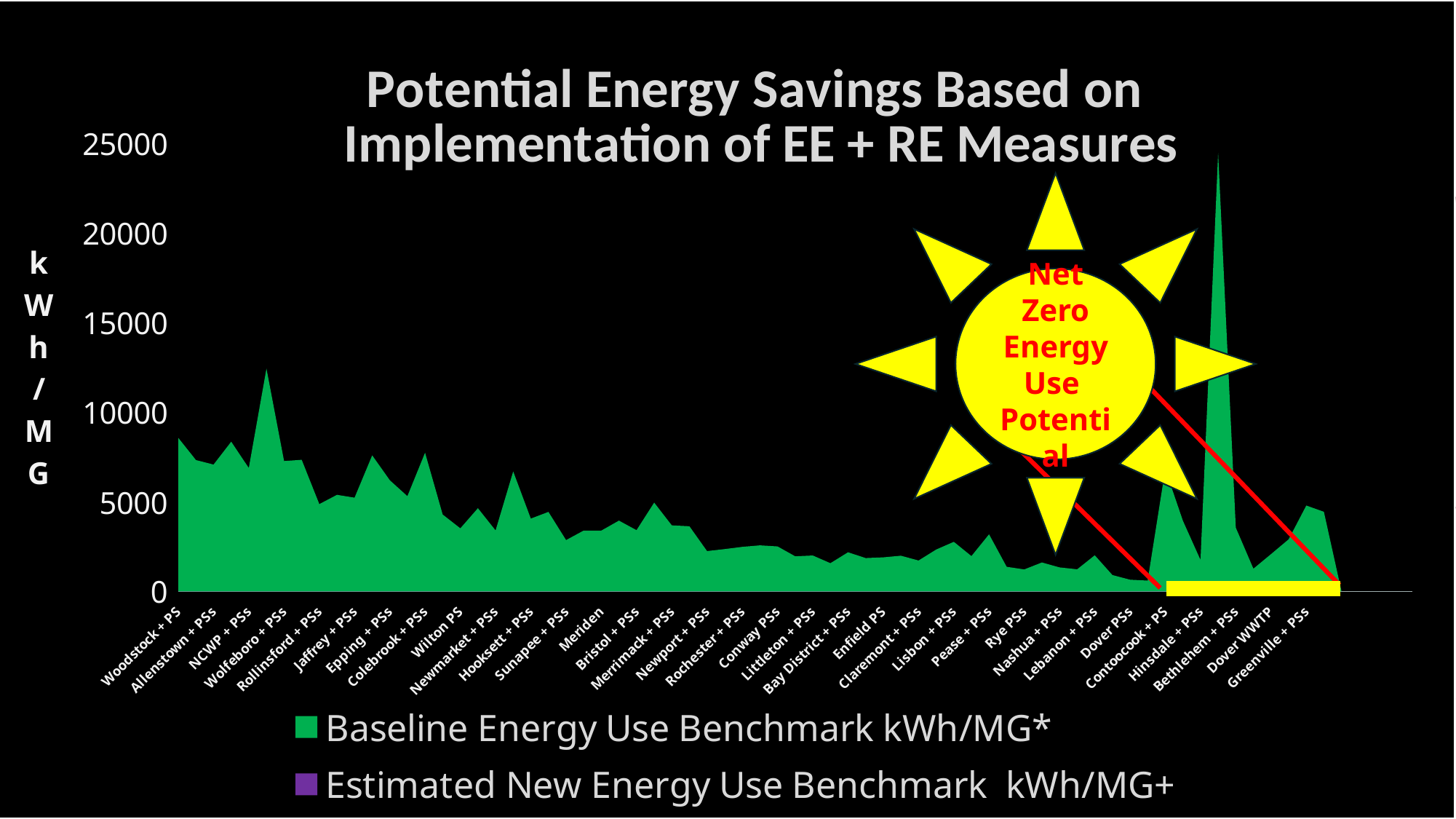
What is the highest value shown on the vertical axis? 25000 How many series does the legend list? 2 Is the Baseline Energy Use Benchmark value for Woodstock + PS greater or less than 5000? greater What kind of chart is shown on the slide? Area chart What is the title of the chart? Potential Energy Savings Based on Implementation of EE + RE Measures Which has the larger Baseline Energy Use Benchmark value, Woodstock + PS or Greenville + PSs? Woodstock + PS Is the Baseline Energy Use Benchmark value for Woodstock + PS greater or less than 10000? less Is the highest peak on the chart greater or less than 20000? greater Ignoring the individual spikes, do the Baseline Energy Use Benchmark values generally rise or fall from left to right along the x axis? fall Which series is shown in green in the legend? Baseline Energy Use Benchmark kWh/MG* Which has the larger Baseline Energy Use Benchmark value, Woodstock + PS or Meriden? Woodstock + PS